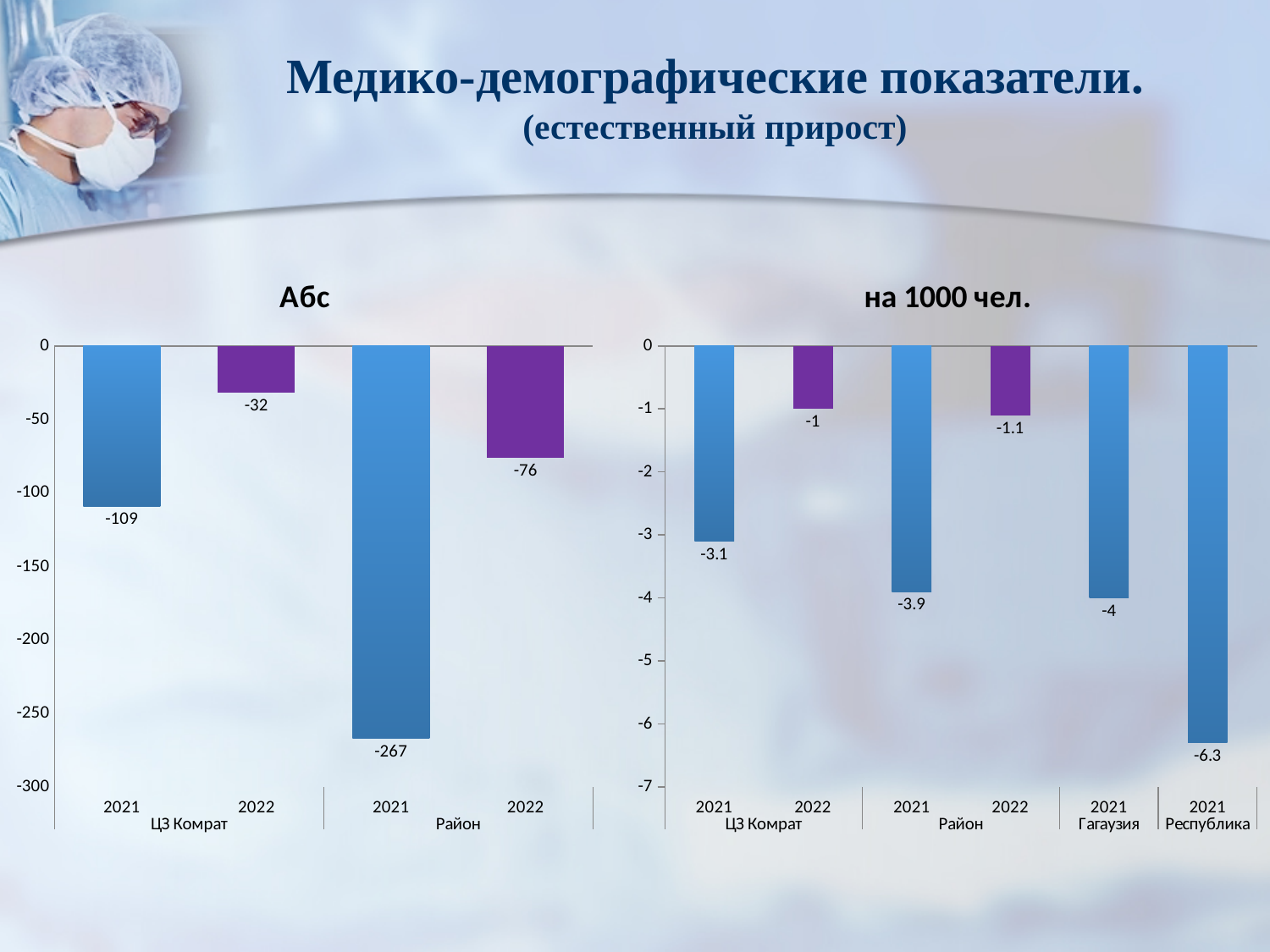
In the "на 1000 чел." chart, what is the value for ЦЗ Комрат in 2022? -1 In the "на 1000 чел." chart, what is the value for Республика in 2021? -6.3 In the "Абс" chart, how many bars are plotted? 4 In the "на 1000 чел." chart, which is larger: the value for ЦЗ Комрат 2021 or Район 2021? ЦЗ Комрат 2021 In the "Абс" chart, what is the value for ЦЗ Комрат in 2021? -109 In the "на 1000 чел." chart, how many bars are plotted? 6 What type of chart is the "Абс" chart? Bar chart In the "Абс" chart, which bar has the lowest value? Район 2021 In the "Абс" chart, what is the difference between the Район 2021 value and the Район 2022 value? 191 In the "Абс" chart, what is the value for Район in 2022? -76 In the "на 1000 чел." chart, which bar has the lowest value? Республика 2021 In the "на 1000 чел." chart, what is the value for Гагаузия in 2021? -4